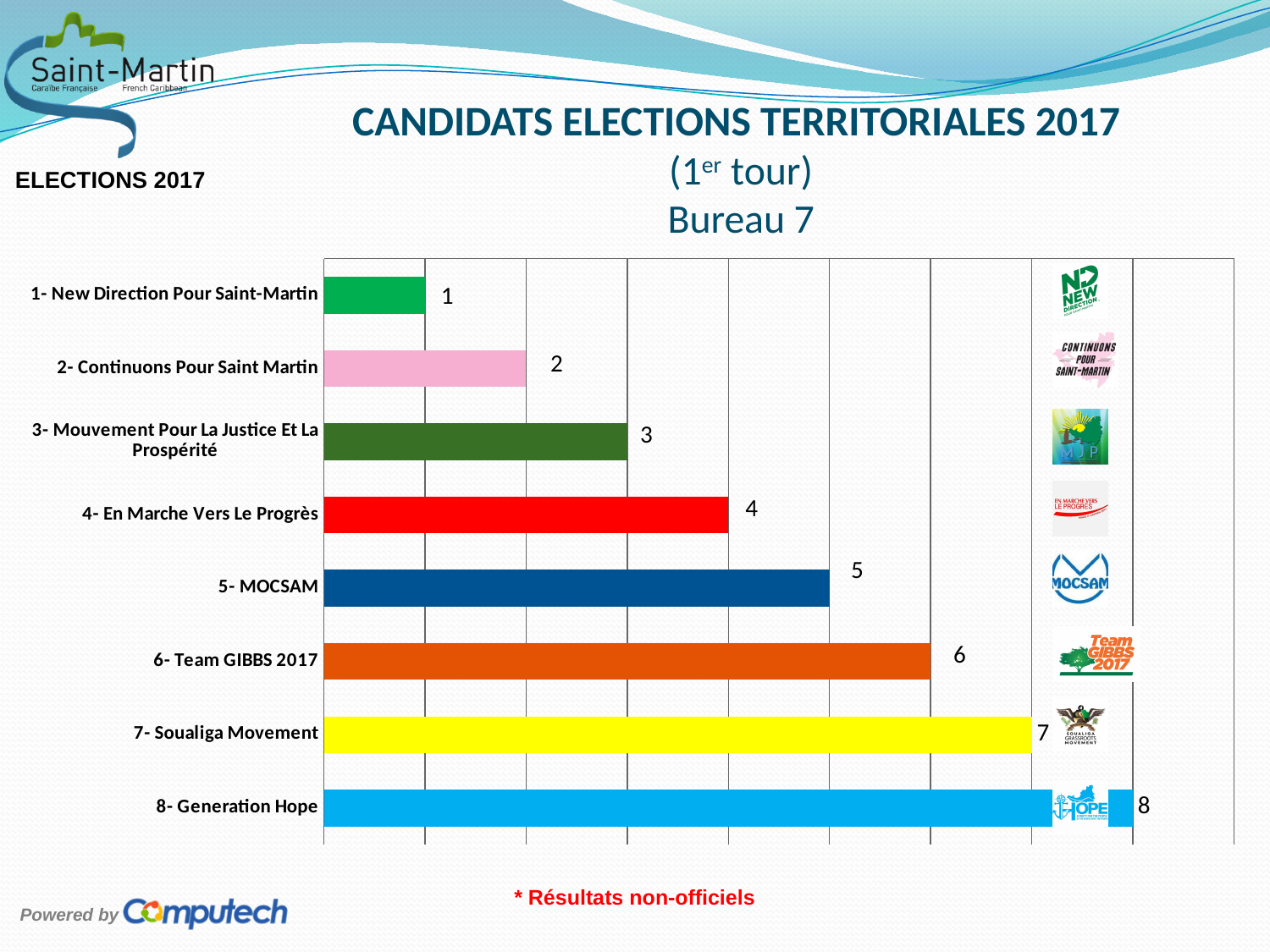
What is the value for 7- Soualiga Movement? 7 Which category has the highest value? 8- Generation Hope What is the value for 3- Mouvement Pour La Justice Et La Prospérité? 3 What is the value for 2- Continuons Pour Saint Martin? 2 What kind of chart is shown on the slide? Bar chart What is the difference between the values for 6- Team GIBBS 2017 and 4- En Marche Vers Le Progrès? 2 Do the values increase or decrease going down the list of categories from top to bottom? Increase What is the title of the chart? CANDIDATS ELECTIONS TERRITORIALES 2017 (1er tour) Bureau 7 How many categories are shown in the chart? 8 What is the value for 5- MOCSAM? 5 Which category has the lowest value? 1- New Direction Pour Saint-Martin Which is larger, the value for 5- MOCSAM or the value for 2- Continuons Pour Saint Martin? 5- MOCSAM